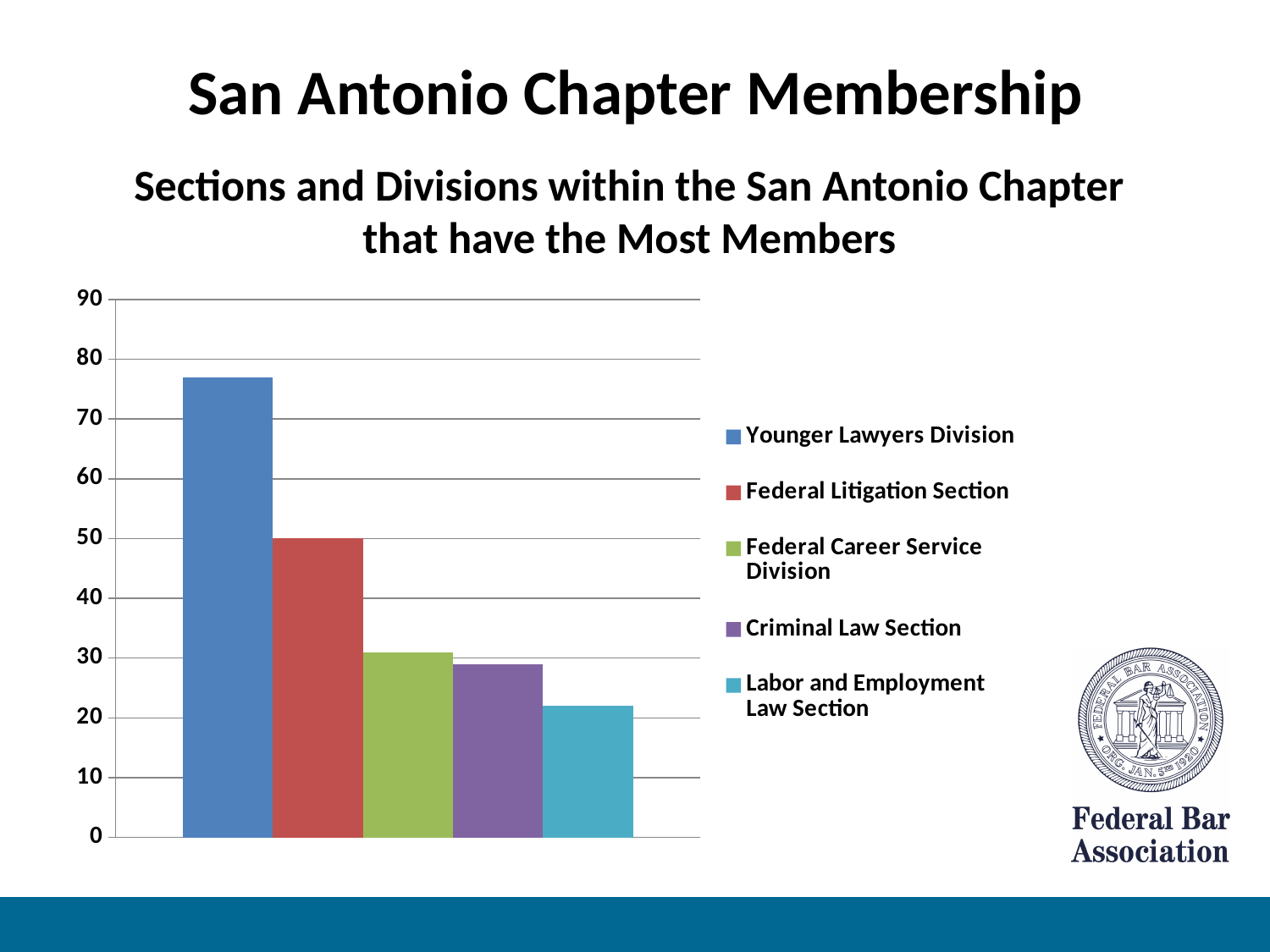
Is the value for the Labor and Employment Law Section greater or less than 30? less Which has more members, the Younger Lawyers Division or the Federal Litigation Section? Younger Lawyers Division How many entries does the chart's legend list? 5 Which has more members, the Federal Litigation Section or the Labor and Employment Law Section? Federal Litigation Section Is the value for the Criminal Law Section greater or less than 40? less Do the bar values rise or fall from left to right across the chart? fall Which section or division has the lowest number of members in the chart? Labor and Employment Law Section Is the value for the Younger Lawyers Division greater or less than 70? greater Which section or division has the highest number of members in the chart? Younger Lawyers Division What kind of chart is shown on the slide? bar chart What is the title of the chart? Sections and Divisions within the San Antonio Chapter that have the Most Members How many bars are plotted in the chart? 5